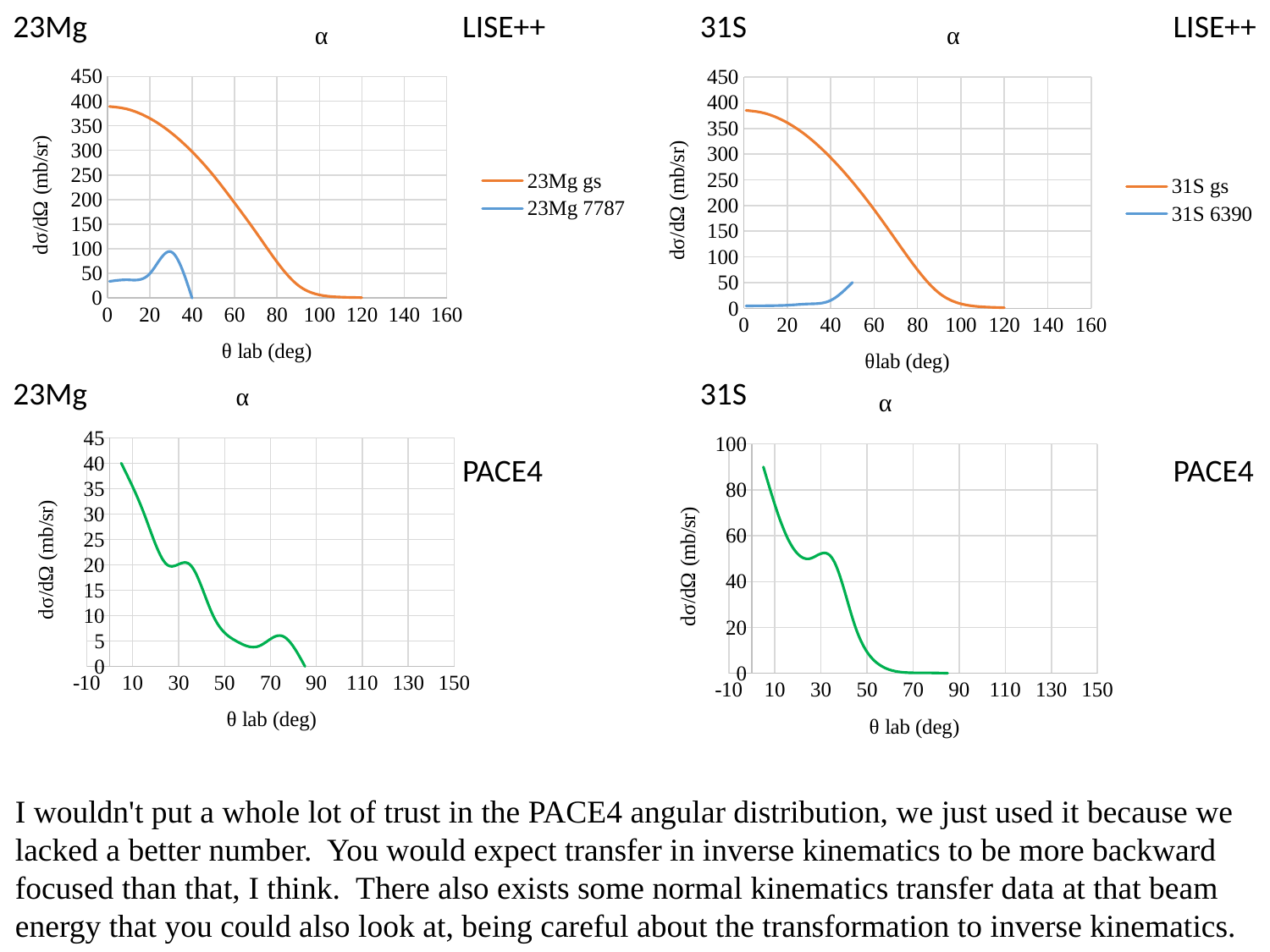
On the top-right chart (31S, LISE++), is the value for 31S gs at 0 degrees greater or less than 350? greater On the top-left chart (23Mg, LISE++), does the 23Mg gs series rise or fall as θ lab increases? fall How many charts are shown on the slide? 4 On the top-left chart (23Mg, LISE++), is the value for 23Mg gs at 0 degrees greater or less than 350? greater On the bottom-right chart (31S, PACE4), does the curve overall rise or fall as θ lab increases? fall On the bottom-right chart (31S, PACE4), is the value at 70 degrees greater or less than 20? less What kind of chart is the top-left chart (23Mg, LISE++)? line chart What is the y-axis label on the top-left chart (23Mg, LISE++)? dσ/dΩ (mb/sr) On the top-left chart (23Mg, LISE++), how many series does the legend list? 2 On the top-right chart (31S, LISE++), what are the two legend entries? 31S gs and 31S 6390